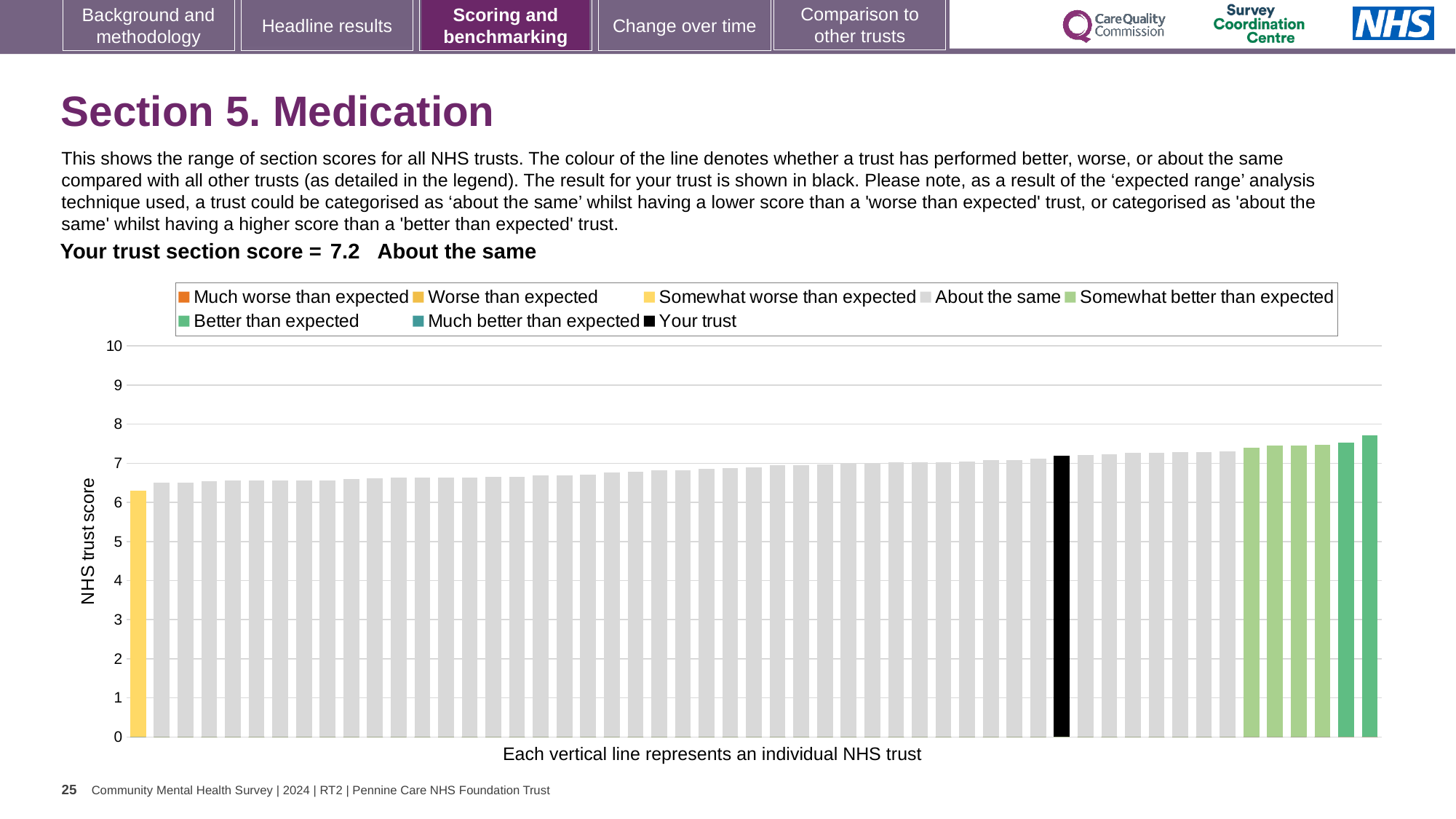
How many entries does the chart legend list? 8 What is the label on the y axis of the chart? NHS trust score Is the value of the lowest bar (the yellow bar) greater or less than 7? less Do the bar values rise or fall from left to right along the x axis? rise Which is larger, the black 'Your trust' bar or the yellow 'Worse than expected' bar? Your trust What is the trust's section score for Medication? 7.2 How many bars are coloured as 'Better than expected'? 2 What kind of chart is shown on the slide? bar chart Is the value of the highest bar greater or less than 7? greater What colour is the bar representing your trust? black How many bars are coloured as 'Somewhat better than expected'? 4 Is the value of the lowest bar (the yellow bar) greater or less than 6? greater